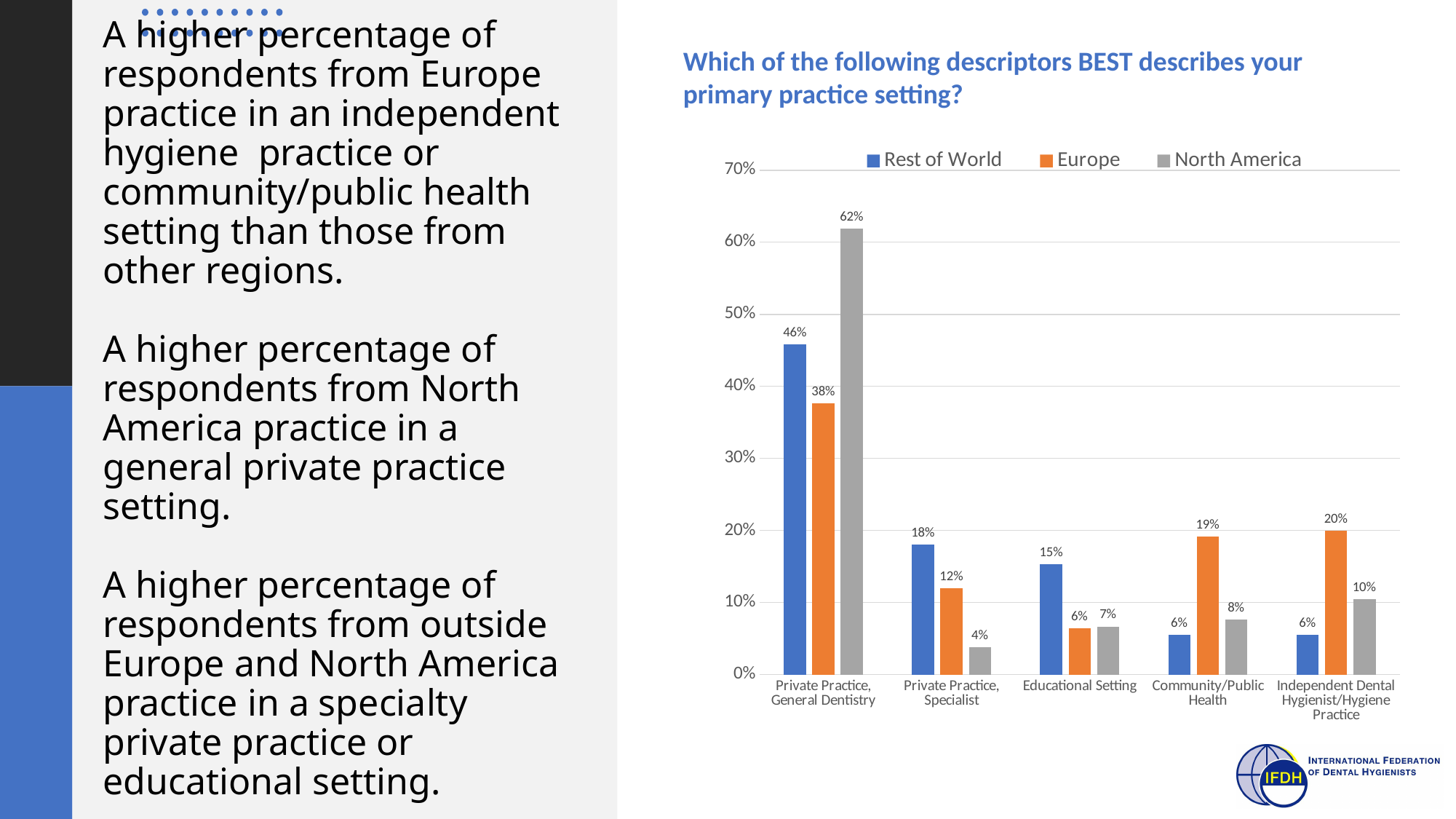
What percentage of Rest of World respondents selected Educational Setting? 15% What percentage of North America respondents selected Private Practice, General Dentistry? 62% Which region has the highest percentage for Community/Public Health? Europe What is the difference between the North America and Europe percentages for Private Practice, General Dentistry? 24% Which is larger for Educational Setting: the Rest of World value or the Europe value? Rest of World How many practice setting categories are shown on the x axis? 5 How many series does the legend list? 3 Which region has the lowest percentage for Private Practice, Specialist? North America What kind of chart is shown on the slide? Bar chart Which colour represents Europe in the chart? Orange What percentage of Europe respondents selected Independent Dental Hygienist/Hygiene Practice? 20% Is the Rest of World value for Private Practice, General Dentistry greater or less than 40%? greater